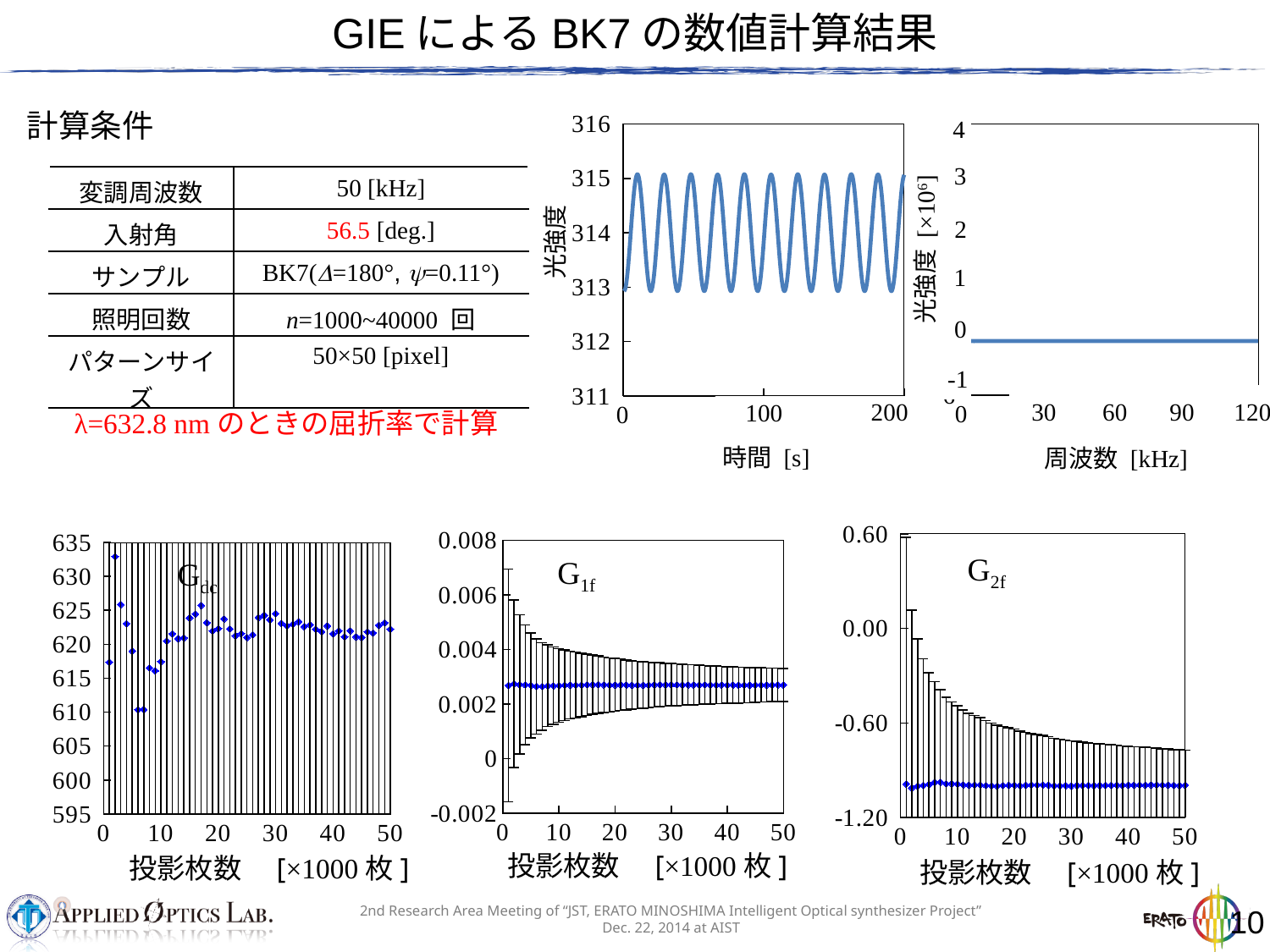
What is the x-axis label of the top-right chart? 周波数 [kHz] In the top-right chart (光強度 [×10^6] vs 周波数 [kHz]), does the plotted line rise, fall, or stay flat along the x axis? stays flat In the top-right chart (光強度 [×10^6] vs 周波数 [kHz]), is the plotted value at 60 kHz greater or less than 1? less In the bottom-left chart labelled Gdc, is the lowest plotted value greater or less than 615? less In the bottom-left chart labelled Gdc, is the highest plotted value greater or less than 630? greater What kind of chart is the top-middle chart with the x axis 時間 [s]? line chart What is the x-axis label of the three bottom charts? 投影枚数 [×1000 枚] In the bottom-middle chart labelled G1f, do the error bars get larger or smaller as 投影枚数 increases? smaller